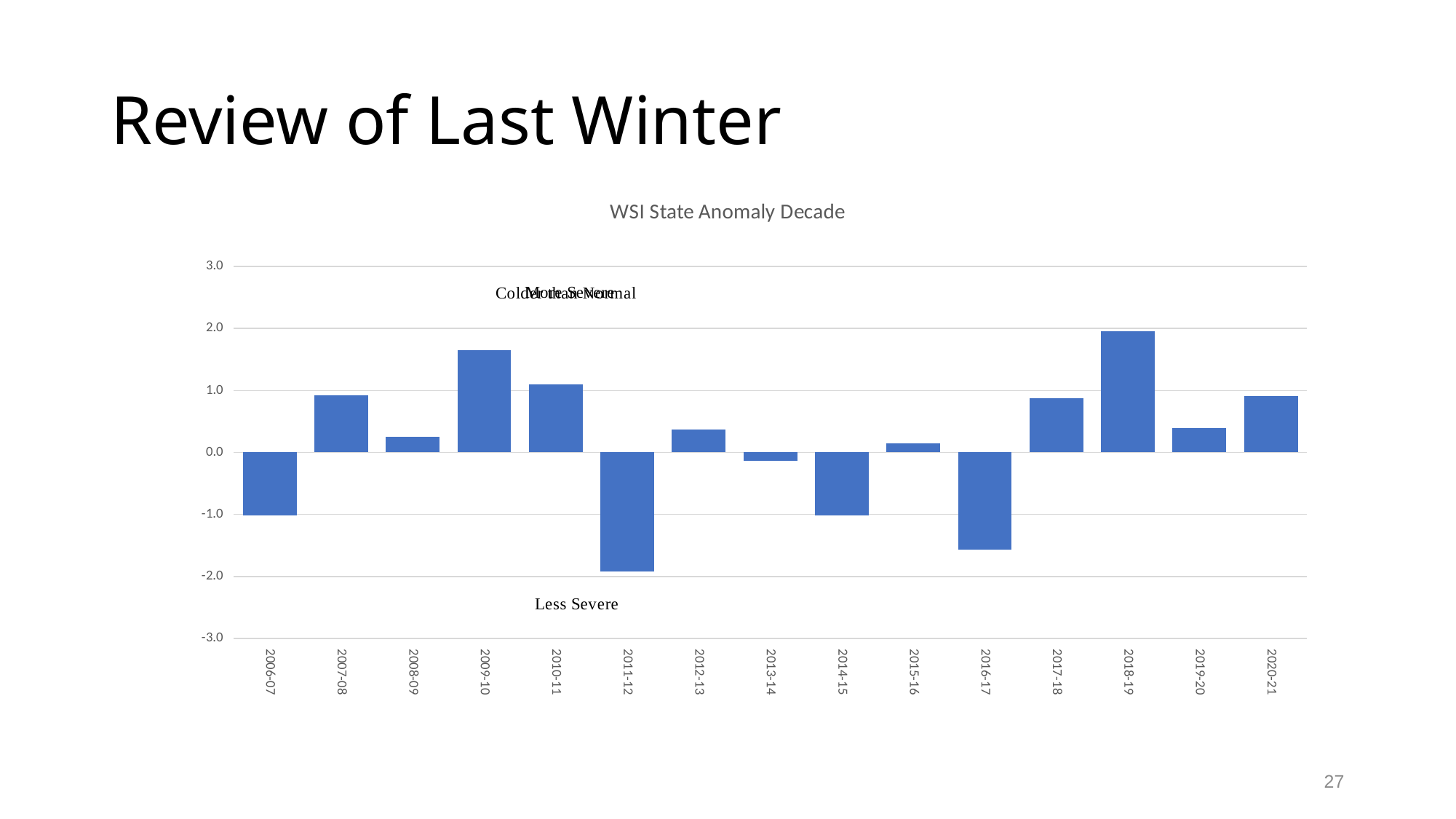
Which winter season has the lowest value? 2011-12 How many winter seasons have a negative value (bar below zero)? 5 Is the value for 2016-17 greater or less than -1.0? less What is the title of the chart? WSI State Anomaly Decade What kind of chart is shown on the slide? bar chart Is the value for 2008-09 greater or less than 1.0? less Which has the larger value, 2009-10 or 2010-11? 2009-10 Which winter season has the highest value? 2018-19 Which has the lower value, 2014-15 or 2016-17? 2016-17 Is the value for 2011-12 greater or less than -1.0? less How many winter seasons are plotted on the x axis? 15